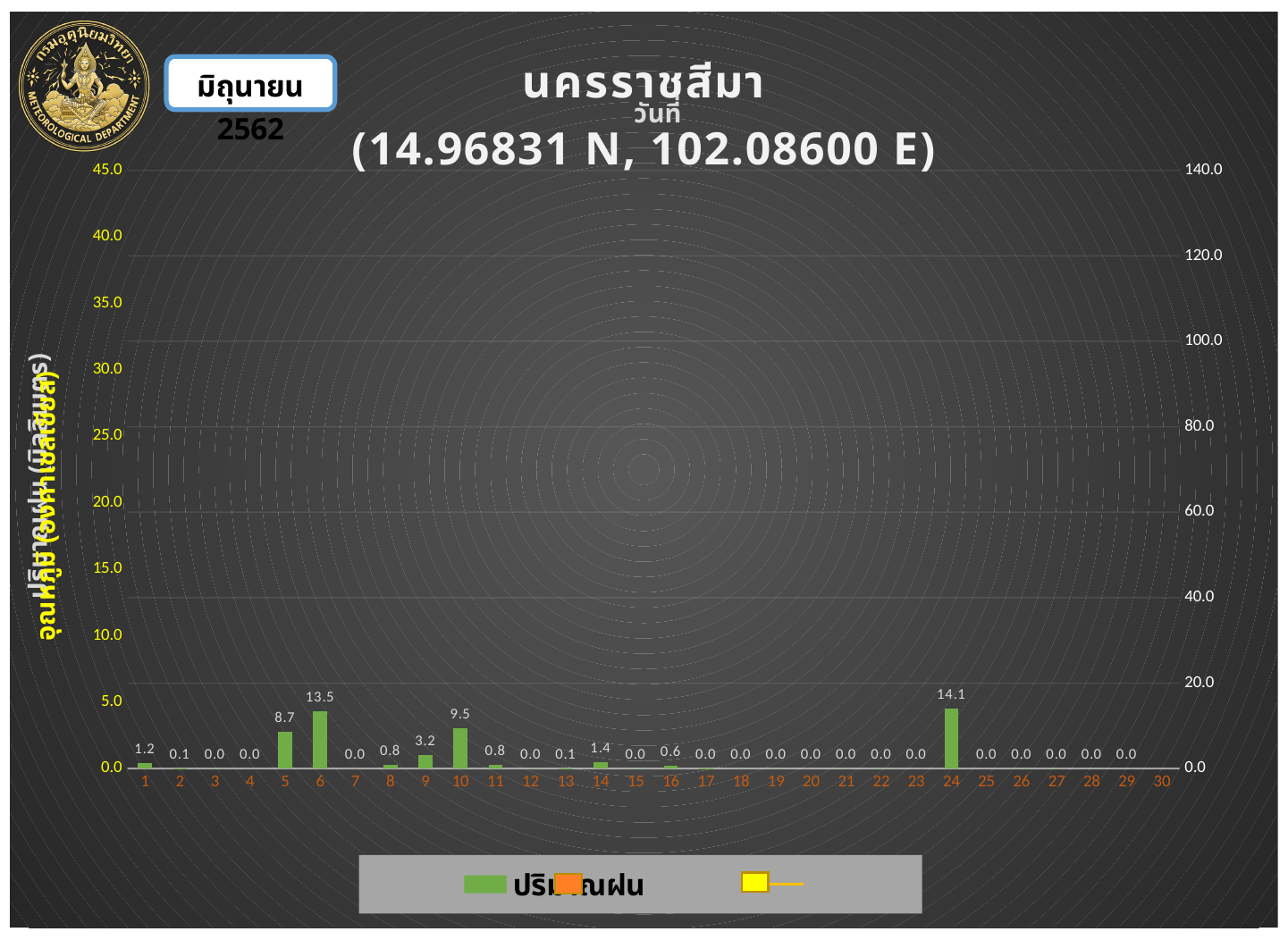
What is the value shown for day 10? 9.5 Which has the larger value, day 5 or day 10? day 10 What is the value shown for day 6? 13.5 What is the difference between the values for day 24 and day 6? 0.6 Which day has the highest value? 24 What is the value shown for day 14? 1.4 What is the value shown for day 24? 14.1 Which has the larger value, day 1 or day 14? day 14 What kind of chart is this? bar chart What is the difference between the values for day 6 and day 9? 10.3 How many days are shown on the x axis? 30 What are the coordinates shown in the chart title? 14.96831 N, 102.08600 E